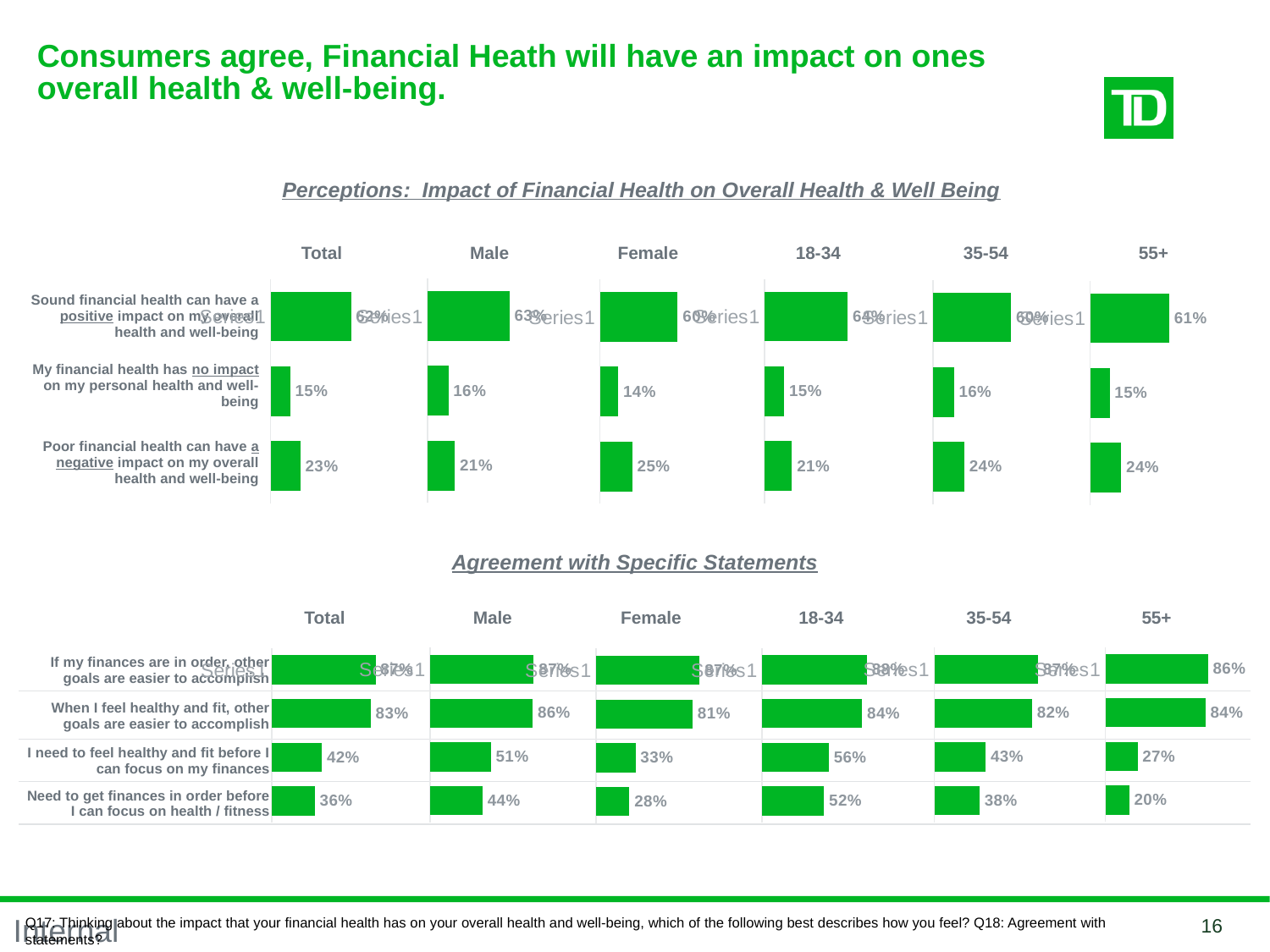
How many demographic groups (columns) are shown in the 'Agreement with Specific Statements' chart? 6 In the 'Perceptions' chart, what percentage of Females say their financial health has no impact on their personal health and well-being? 14% In the 'Perceptions: Impact of Financial Health on Overall Health & Well Being' chart, what percentage of the 55+ group say sound financial health can have a positive impact on their overall health and well-being? 61% In the 'Agreement with Specific Statements' chart, what is the difference between the Male and Female percentages for 'I need to feel healthy and fit before I can focus on my finances'? 18% In the 'Agreement with Specific Statements' chart, what percentage of the 55+ group agree they need to feel healthy and fit before they can focus on their finances? 27% In the 'Perceptions' chart, what percentage of the Total group say poor financial health can have a negative impact on their overall health and well-being? 23% In the 'Agreement with Specific Statements' chart, what percentage of the 18-34 group agree they need to get finances in order before they can focus on health / fitness? 52% In the 'Agreement with Specific Statements' chart, which group has the lowest percentage agreeing they need to get finances in order before they can focus on health / fitness? 55+ In the 'Perceptions' chart, which group has the highest percentage saying poor financial health can have a negative impact on their overall health and well-being? Female In the 'Agreement with Specific Statements' chart, which group has the highest percentage agreeing they need to feel healthy and fit before they can focus on their finances? 18-34 In the 'Perceptions' chart, what is the difference between the Female and Male percentages for 'Poor financial health can have a negative impact on my overall health and well-being'? 4% In the 'Agreement with Specific Statements' chart, is the Male percentage or the Female percentage higher for 'When I feel healthy and fit, other goals are easier to accomplish'? Male